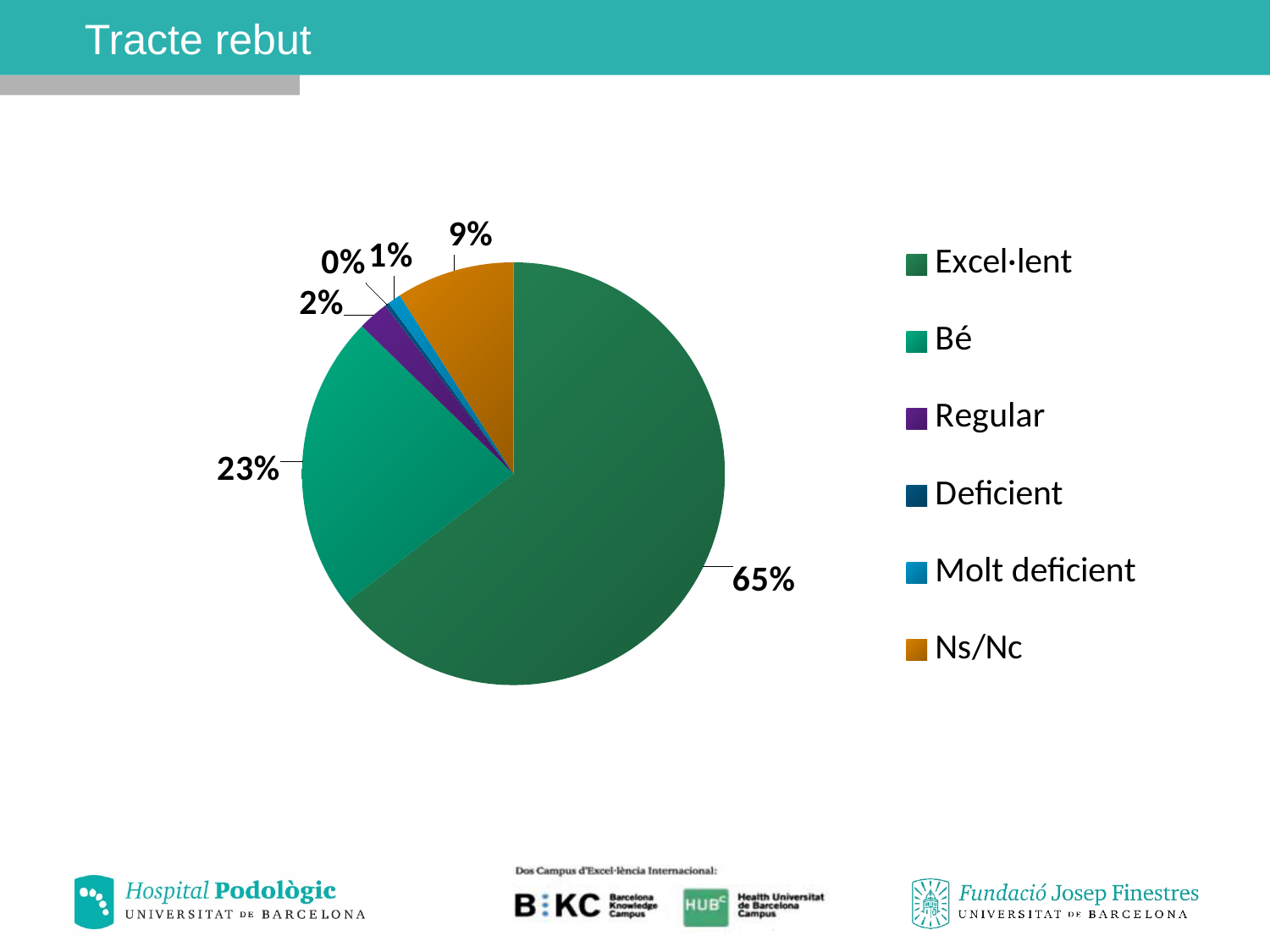
What share of the pie does Deficient represent? 0% What share of the pie does Excel·lent represent? 65% What is the title of the slide containing the pie chart? Tracte rebut What is the difference between the Excel·lent and Bé shares? 42% What share of the pie does Ns/Nc represent? 9% Which category has the smallest slice of the pie? Deficient How many categories does the legend list? 6 What type of chart is shown on the slide? pie chart Which category has the largest slice of the pie? Excel·lent